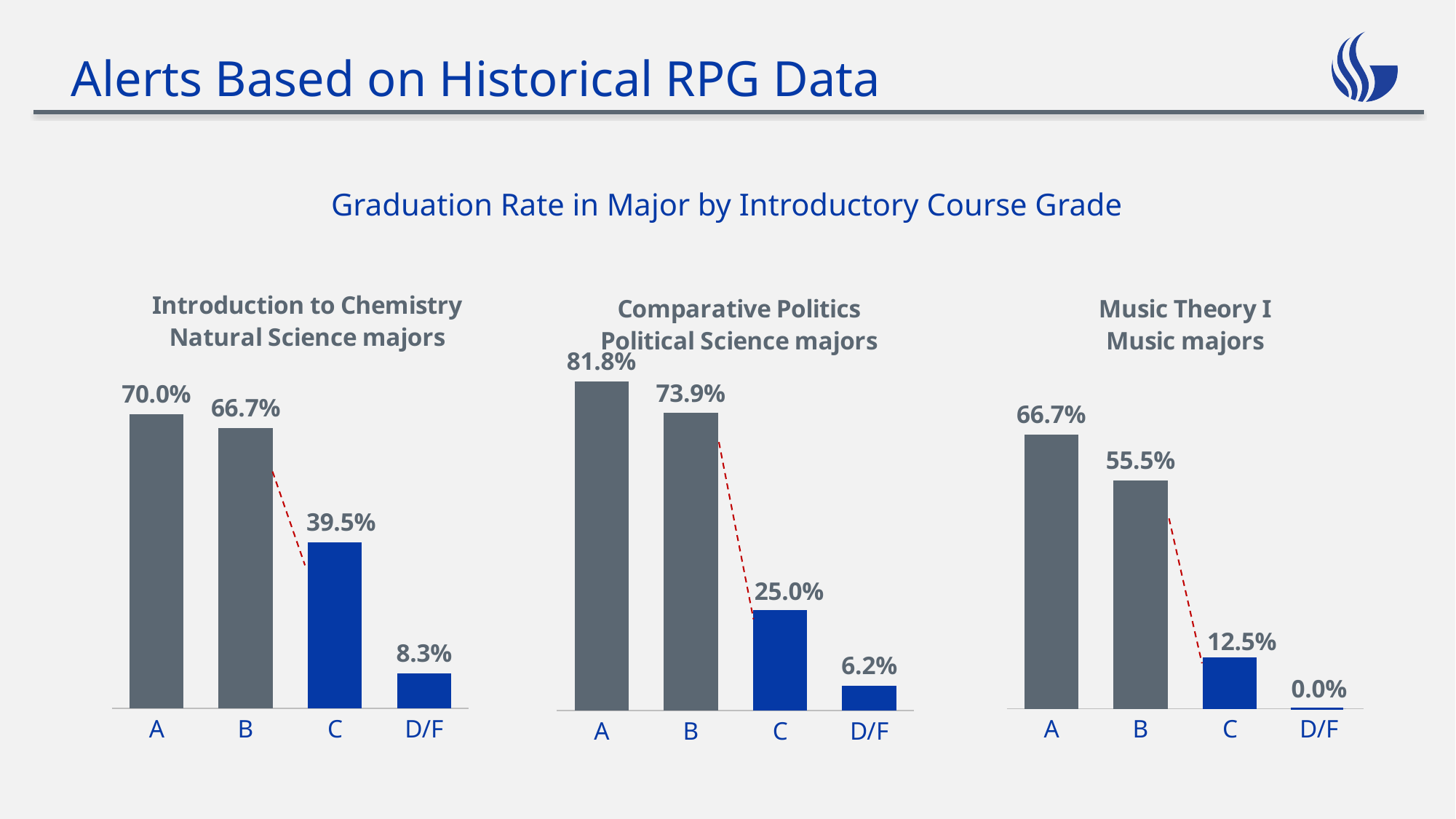
In the Introduction to Chemistry chart, what is the graduation rate for students who earned a B? 66.7% In the Comparative Politics chart, what is the graduation rate for students who earned a C? 25.0% Which is larger: the C-grade graduation rate in the Introduction to Chemistry chart or the C-grade graduation rate in the Music Theory I chart? Introduction to Chemistry In the Comparative Politics chart, which bars are coloured blue rather than grey? C and D/F In the Music Theory I chart, what is the graduation rate for students who earned a D/F? 0.0% In the Introduction to Chemistry chart, do the graduation rates rise or fall from grade A to grade D/F? Fall In the Music Theory I chart, what is the difference between the graduation rates for grades A and B? 11.2% What type of chart is used for Music Theory I? Bar chart In the Introduction to Chemistry chart, which grade has the lowest graduation rate? D/F How many grade categories are shown in the Comparative Politics chart? 4 In the Comparative Politics chart, what is the difference between the graduation rates for grades B and C? 48.9% In the Comparative Politics chart, which grade has the highest graduation rate? A